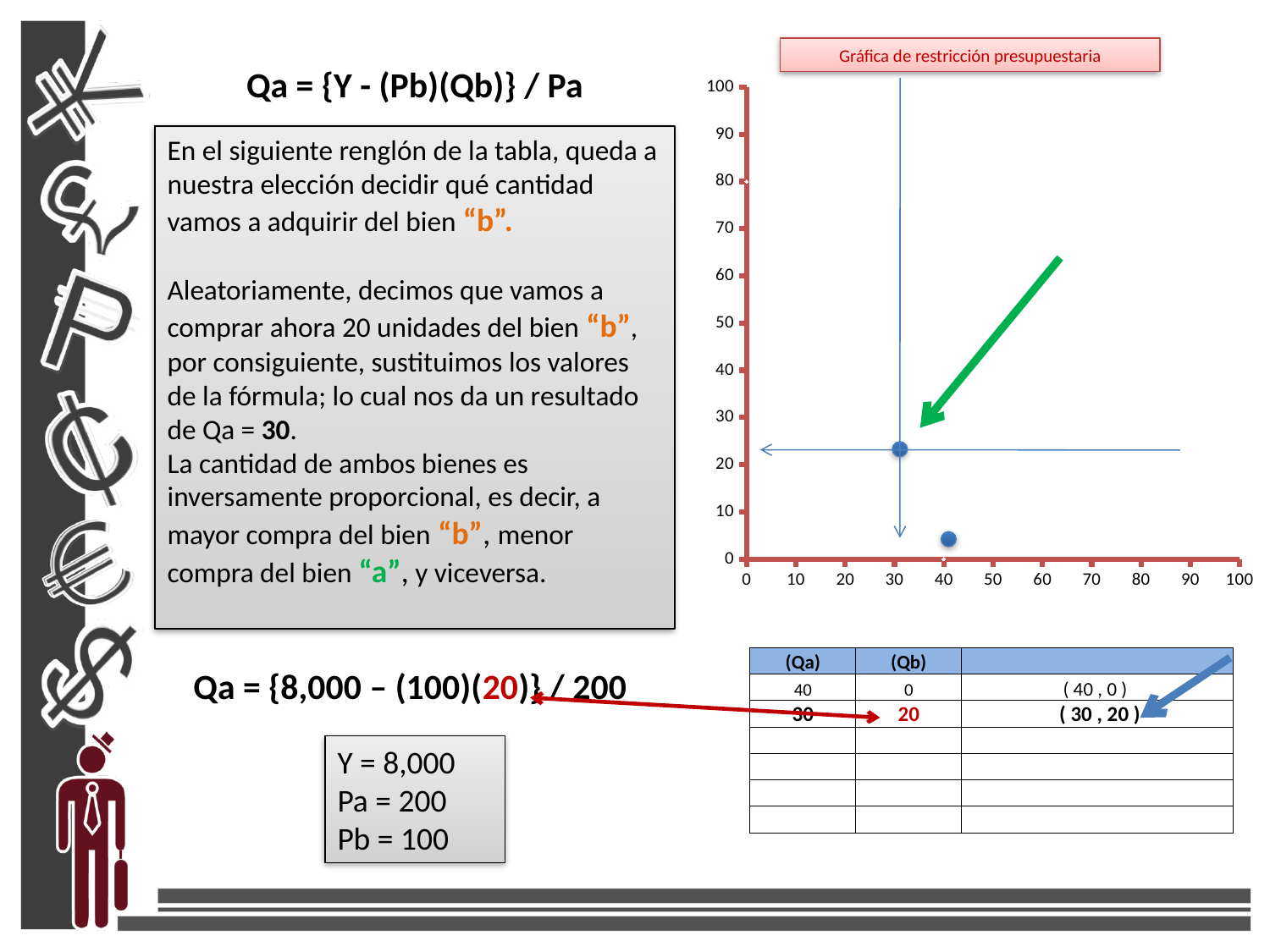
Moving from the left plotted point to the right plotted point, does the y value rise or fall? fall How many data points are plotted on the chart? 2 Of the two plotted points, does the one further left or the one further right have the higher y value? the one further left Is the y value of the upper plotted point greater or less than 10? greater What kind of chart is shown on the slide? scatter chart Is the x value of the right plotted point greater or less than 50? less What coordinate pair does the table on the slide list in its first data row? ( 40 , 0 ) Is the y value of the lower plotted point greater or less than 10? less What is the title of the chart? Gráfica de restricción presupuestaria What coordinate pair does the table on the slide list in its second data row? ( 30 , 20 ) What is the highest value shown on the chart's y axis? 100